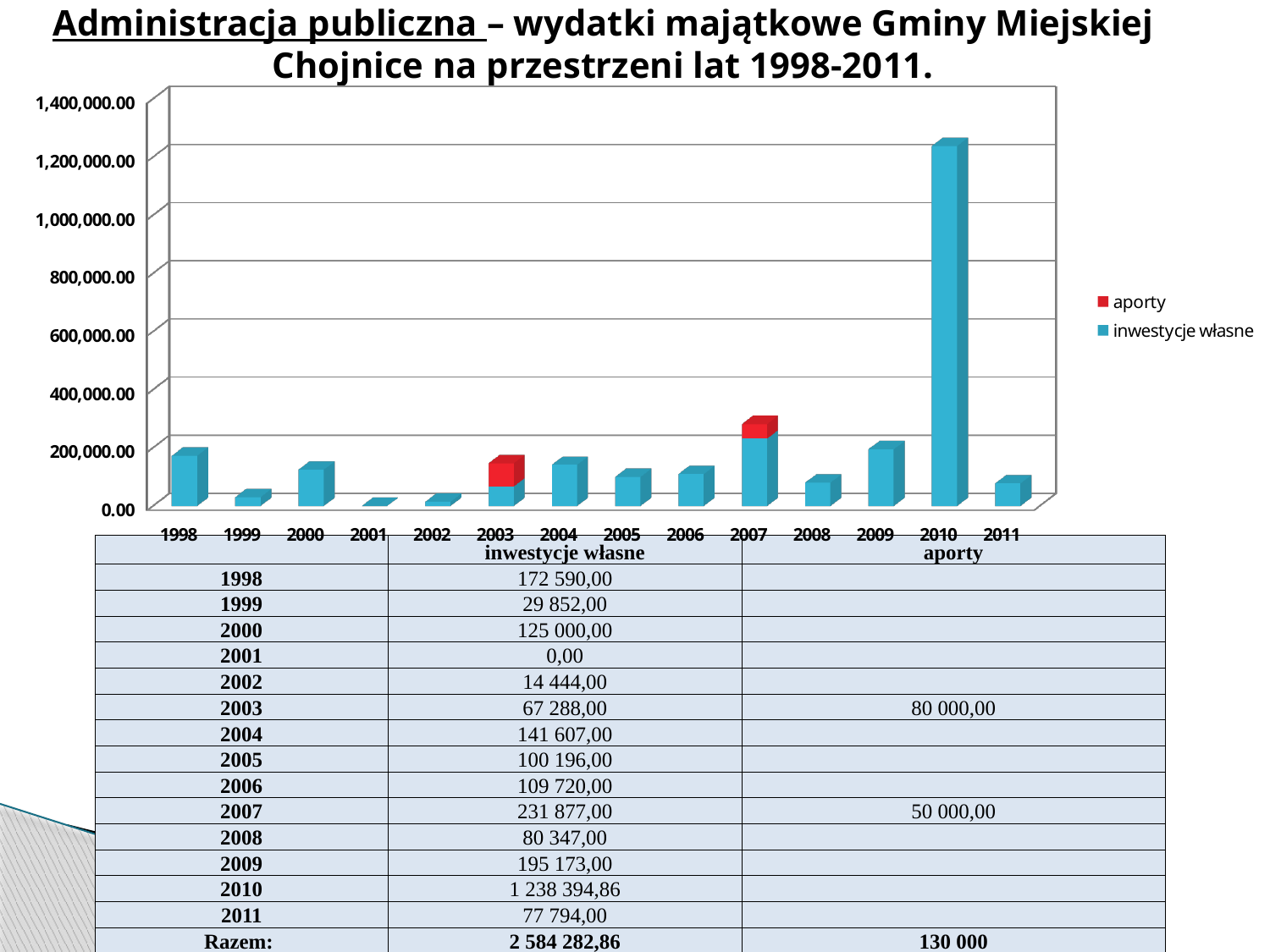
Which is larger, inwestycje własne in 2007 or in 2009? 2007 What is the total of the stacked bar for 2007 (inwestycje własne plus aporty)? 281 877,00 Which year has the lowest value for inwestycje własne? 2001 What is the value of inwestycje własne for 2010? 1 238 394,86 What is the difference between aporty in 2003 and aporty in 2007? 30 000,00 What is the value of aporty for 2003? 80 000,00 Is the value for inwestycje własne in 2010 greater or less than 1,200,000.00? greater What kind of chart is shown on the slide? bar chart How many years are shown on the x axis of the chart? 14 What is the value of inwestycje własne for 1998? 172 590,00 Which year has the highest value for inwestycje własne? 2010 How many series does the chart legend list? 2